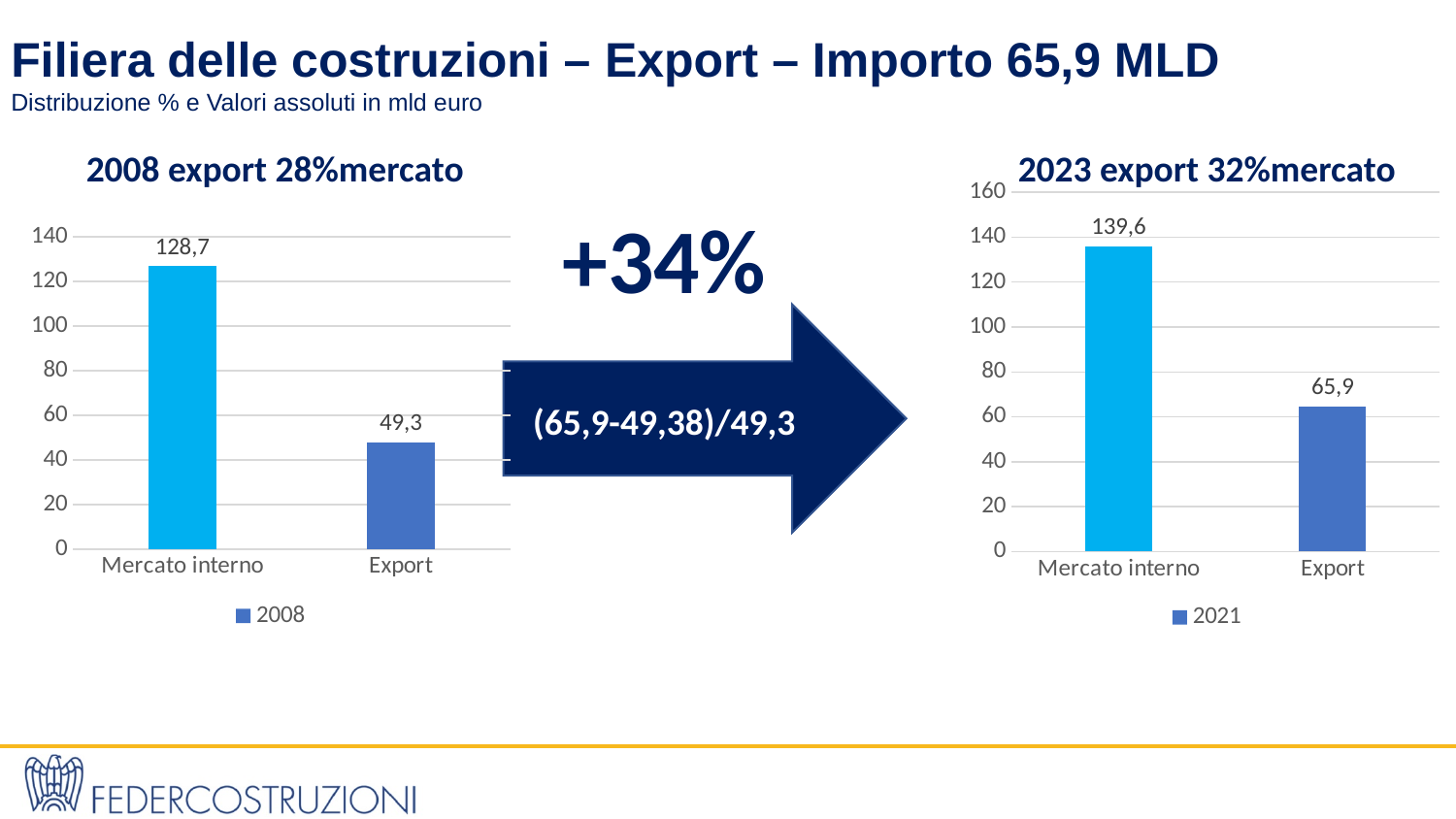
In the right chart titled '2023 export 32%mercato', which category has the lowest value? Export In the left chart titled '2008 export 28%mercato', which category has the highest value? Mercato interno In the right chart titled '2023 export 32%mercato', what is the difference between Mercato interno and Export? 73,7 What is the legend entry shown below the right chart titled '2023 export 32%mercato'? 2021 In the right chart titled '2023 export 32%mercato', how many categories are shown on the x axis? 2 What kind of chart is the left chart titled '2008 export 28%mercato'? Bar chart In the left chart titled '2008 export 28%mercato', what is the value for Mercato interno? 128,7 Is the Export value in the right chart titled '2023 export 32%mercato' larger than the Export value in the left chart titled '2008 export 28%mercato'? Yes In the right chart titled '2023 export 32%mercato', what is the value for Export? 65,9 In the left chart titled '2008 export 28%mercato', what is the value for Export? 49,3 In the right chart titled '2023 export 32%mercato', what is the value for Mercato interno? 139,6 In the left chart titled '2008 export 28%mercato', what is the difference between Mercato interno and Export? 79,4